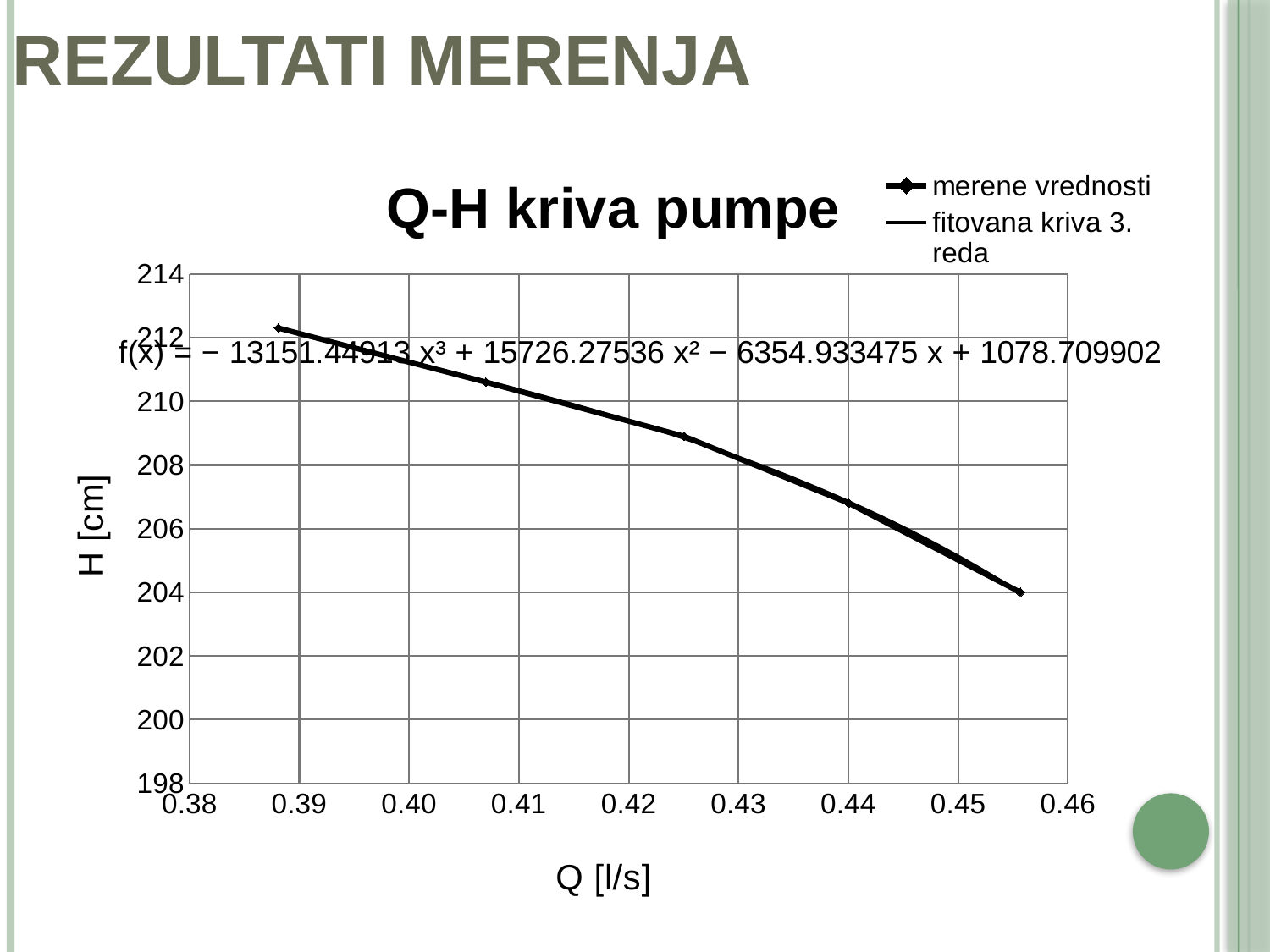
What is the title of the chart? Q-H kriva pumpe What kind of chart is shown on the slide? line chart Which measured point has the highest H value: the one at the smallest Q or the one at the largest Q? the one at the smallest Q Is the H value of the last measured point (near Q = 0.46) greater or less than 206? less Which has the larger H value: the measured point near Q = 0.41 or the one near Q = 0.44? the one near Q = 0.41 Is the H value of the measured point near Q = 0.44 greater or less than 208? less Is the H value of the measured point near Q = 0.425 greater or less than 208? greater How many measured data points are plotted on the chart? 5 How many series does the legend list? 2 Do the H values rise or fall as Q increases along the x axis? fall What is the label of the vertical axis? H [cm]